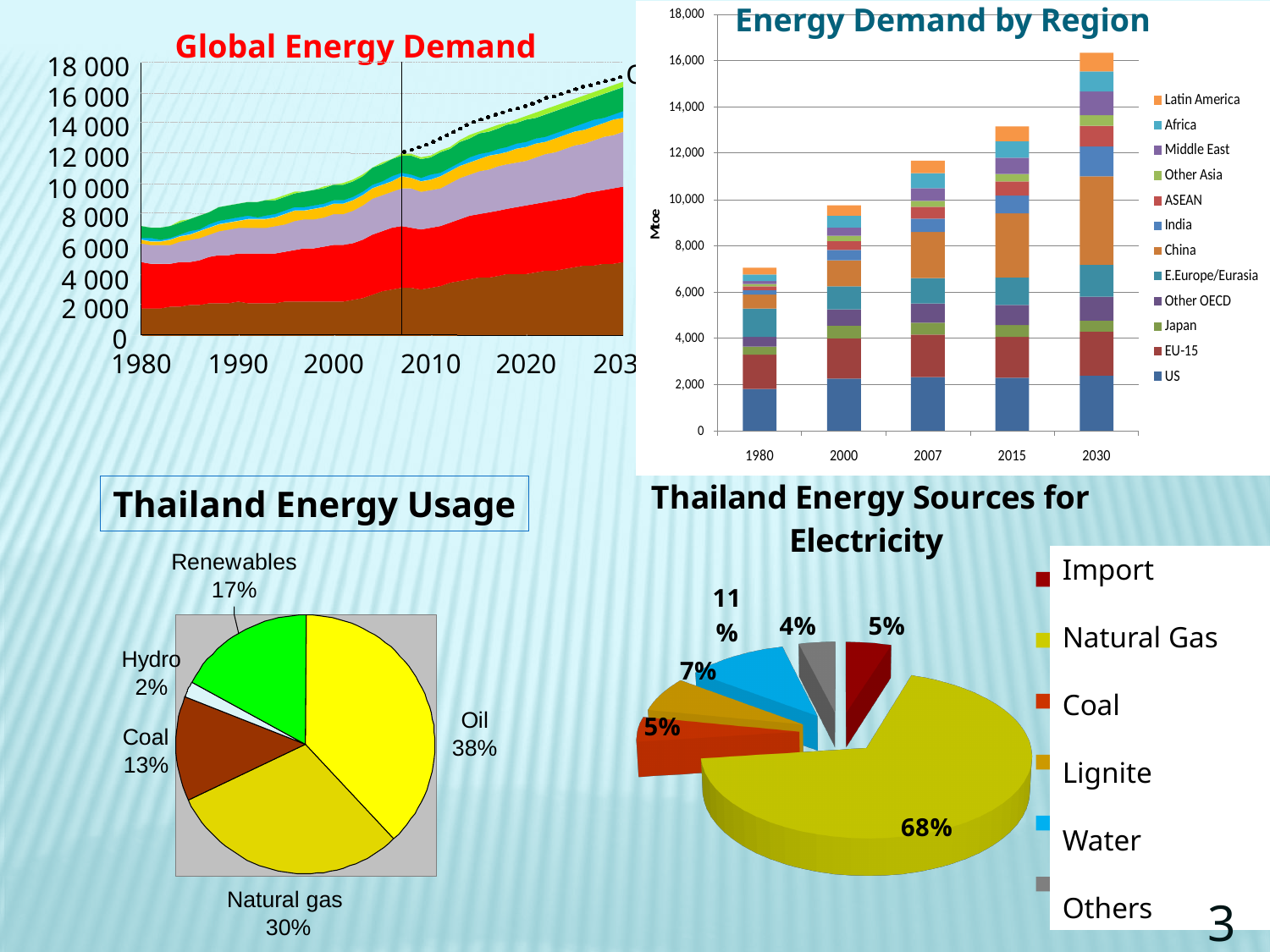
How many slices does the Thailand Energy Usage pie chart have? 5 What kind of chart is the Energy Demand by Region chart? Stacked bar chart How many years are shown on the x axis of the Energy Demand by Region chart? 5 How many entries does the legend of the Thailand Energy Sources for Electricity chart list? 6 In the Thailand Energy Sources for Electricity chart, what share does Water have? 11% In the Thailand Energy Sources for Electricity chart, what share does Natural Gas have? 68% In the Thailand Energy Usage pie chart, what share does Oil have? 38% In the Energy Demand by Region chart, is the total for 1980 greater or less than 8,000? less In the Thailand Energy Usage pie chart, which source has the smallest share? Hydro In the Global Energy Demand chart, do the values rise or fall from 1980 to 2030? rise In the Thailand Energy Usage pie chart, which is larger, Renewables or Coal? Renewables In the Thailand Energy Usage pie chart, what is the difference between the Oil share and the Natural gas share? 8%